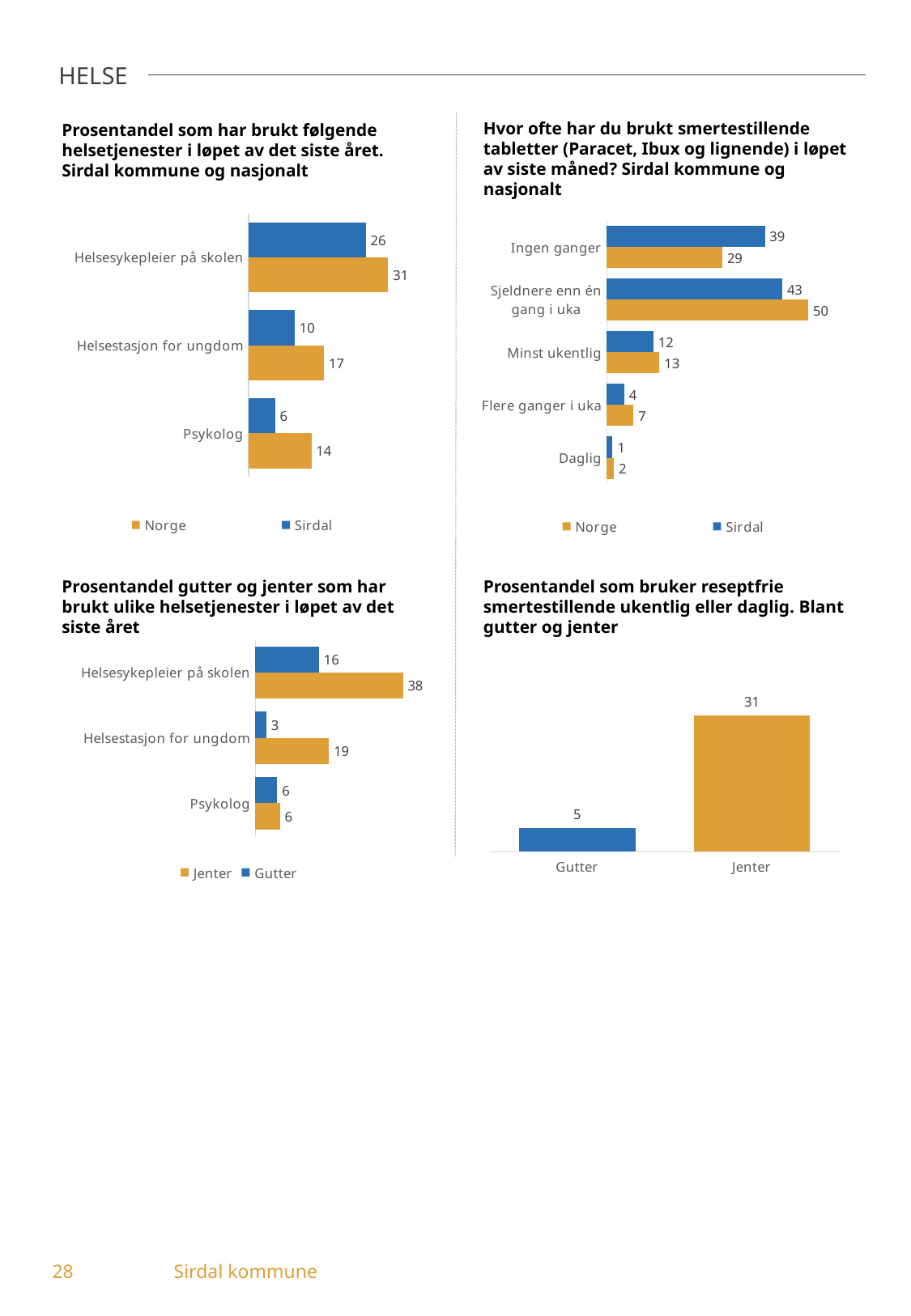
In the top-left chart (Prosentandel som har brukt følgende helsetjenester), what is the difference between Norge and Sirdal for Helsestasjon for ungdom? 7 In the top-left chart (Prosentandel som har brukt følgende helsetjenester), what is the value for Norge for Helsesykepleier på skolen? 31 In the top-right chart (Hvor ofte har du brukt smertestillende tabletter), which category has the highest value for Norge? Sjeldnere enn én gang i uka In the bottom-left chart (Prosentandel gutter og jenter som har brukt ulike helsetjenester), what is the difference between Jenter and Gutter for Helsesykepleier på skolen? 22 In the top-right chart (Hvor ofte har du brukt smertestillende tabletter), what is the value for Sirdal for Sjeldnere enn én gang i uka? 43 In the top-right chart (Hvor ofte har du brukt smertestillende tabletter), how many categories are shown? 5 In the bottom-left chart (Prosentandel gutter og jenter som har brukt ulike helsetjenester), what is the value for Jenter for Helsestasjon for ungdom? 19 In the top-left chart (Prosentandel som har brukt følgende helsetjenester), what is the value for Sirdal for Psykolog? 6 In the bottom-right chart (Prosentandel som bruker reseptfrie smertestillende ukentlig eller daglig), what kind of chart is shown? Bar chart In the bottom-right chart (Prosentandel som bruker reseptfrie smertestillende ukentlig eller daglig), what is the value for Jenter? 31 In the top-right chart (Hvor ofte har du brukt smertestillende tabletter), which is larger for Ingen ganger: Norge or Sirdal? Sirdal In the top-right chart (Hvor ofte har du brukt smertestillende tabletter), which category has the lowest value for Sirdal? Daglig